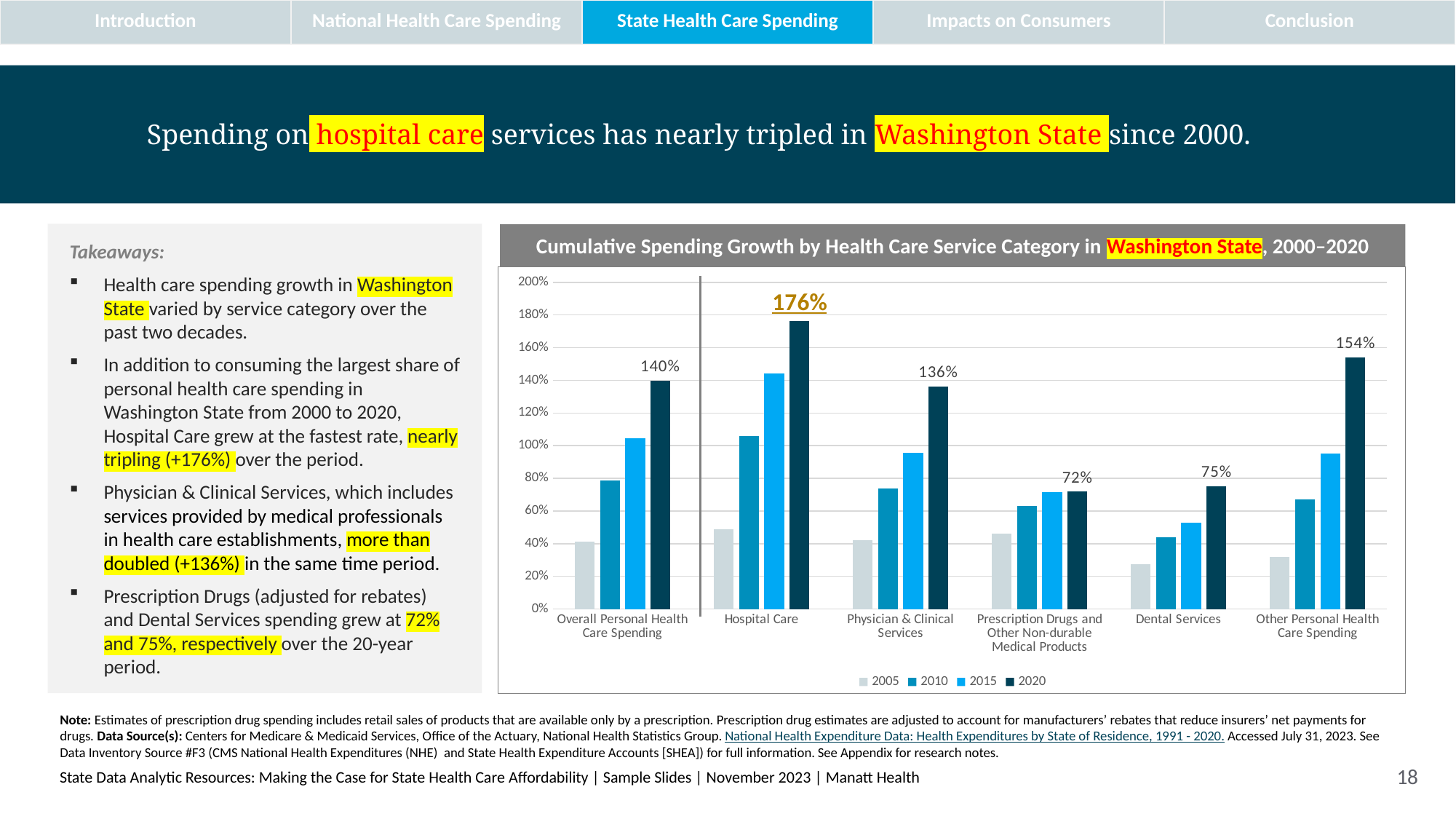
What is the 2020 value shown for Dental Services? 75% Which service category has the lowest 2020 value in the chart? Prescription Drugs and Other Non-durable Medical Products How many series does the chart legend list? 4 Is the 2005 value for Dental Services greater or less than 40%? less Which service category has the highest 2020 value in the chart? Hospital Care How many service categories are shown on the x axis of the chart? 6 Is the 2015 value for Hospital Care greater or less than 120%? greater What kind of chart is used to show cumulative spending growth by service category? Bar chart What is the 2020 value shown for Other Personal Health Care Spending? 154% Which has the larger 2020 value: Other Personal Health Care Spending or Overall Personal Health Care Spending? Other Personal Health Care Spending What is the difference between the 2020 values for Hospital Care and Overall Personal Health Care Spending? 36 percentage points What is the 2020 cumulative spending growth value shown for Hospital Care? 176%